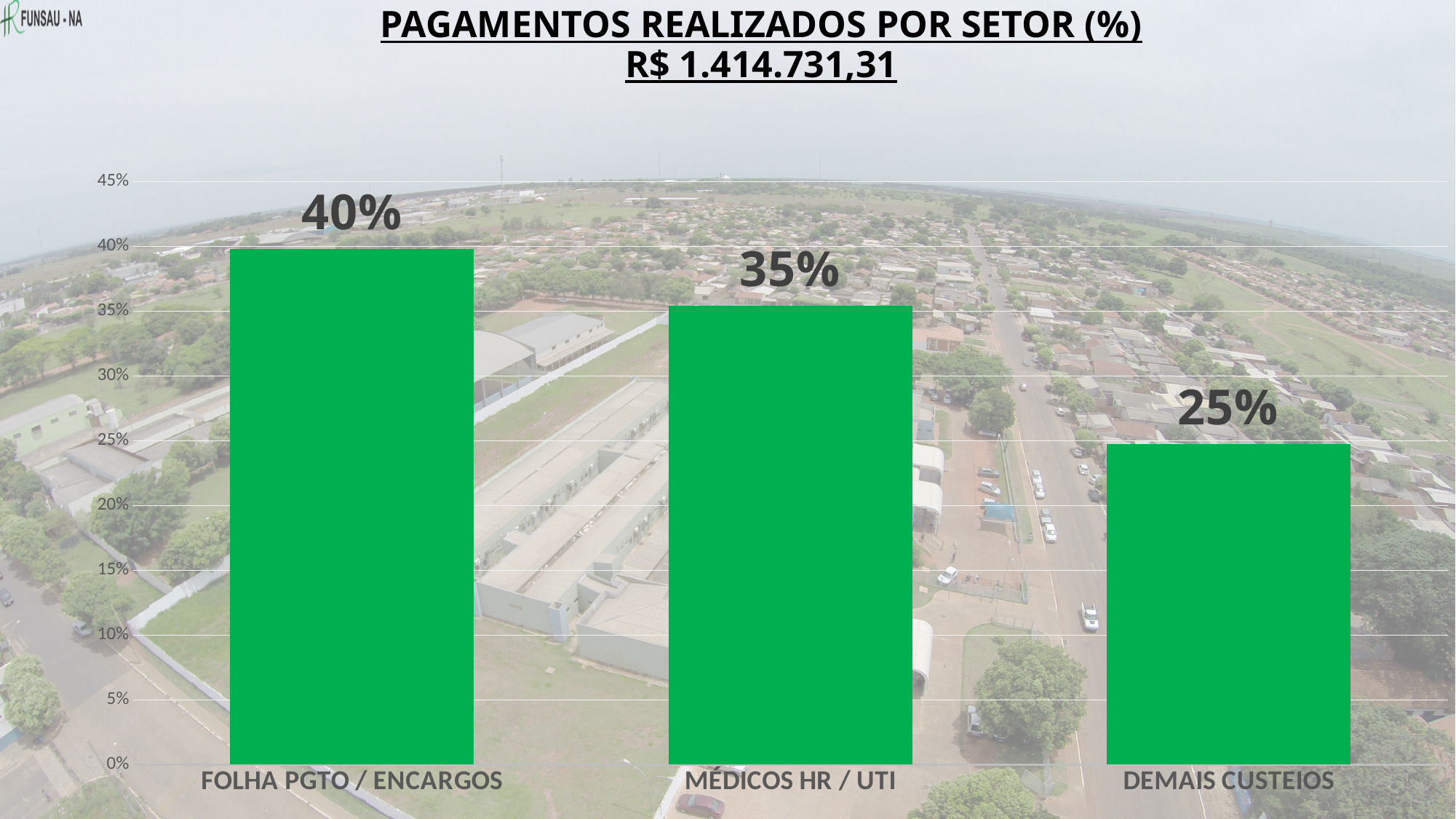
Which category has the lowest value? DEMAIS CUSTEIOS Is the value for DEMAIS CUSTEIOS greater or less than 30%? less What is the value for DEMAIS CUSTEIOS? 25% What is the difference between the values for FOLHA PGTO / ENCARGOS and DEMAIS CUSTEIOS? 15% Which category has the highest value? FOLHA PGTO / ENCARGOS What is the value for FOLHA PGTO / ENCARGOS? 40% What kind of chart is shown on the slide? bar chart What is the value for MÉDICOS HR / UTI? 35% Which is larger, the value for MÉDICOS HR / UTI or the value for DEMAIS CUSTEIOS? MÉDICOS HR / UTI What total amount in R$ is shown in the chart title? R$ 1.414.731,31 What is the difference between the values for MÉDICOS HR / UTI and DEMAIS CUSTEIOS? 10% How many categories are shown in the chart? 3